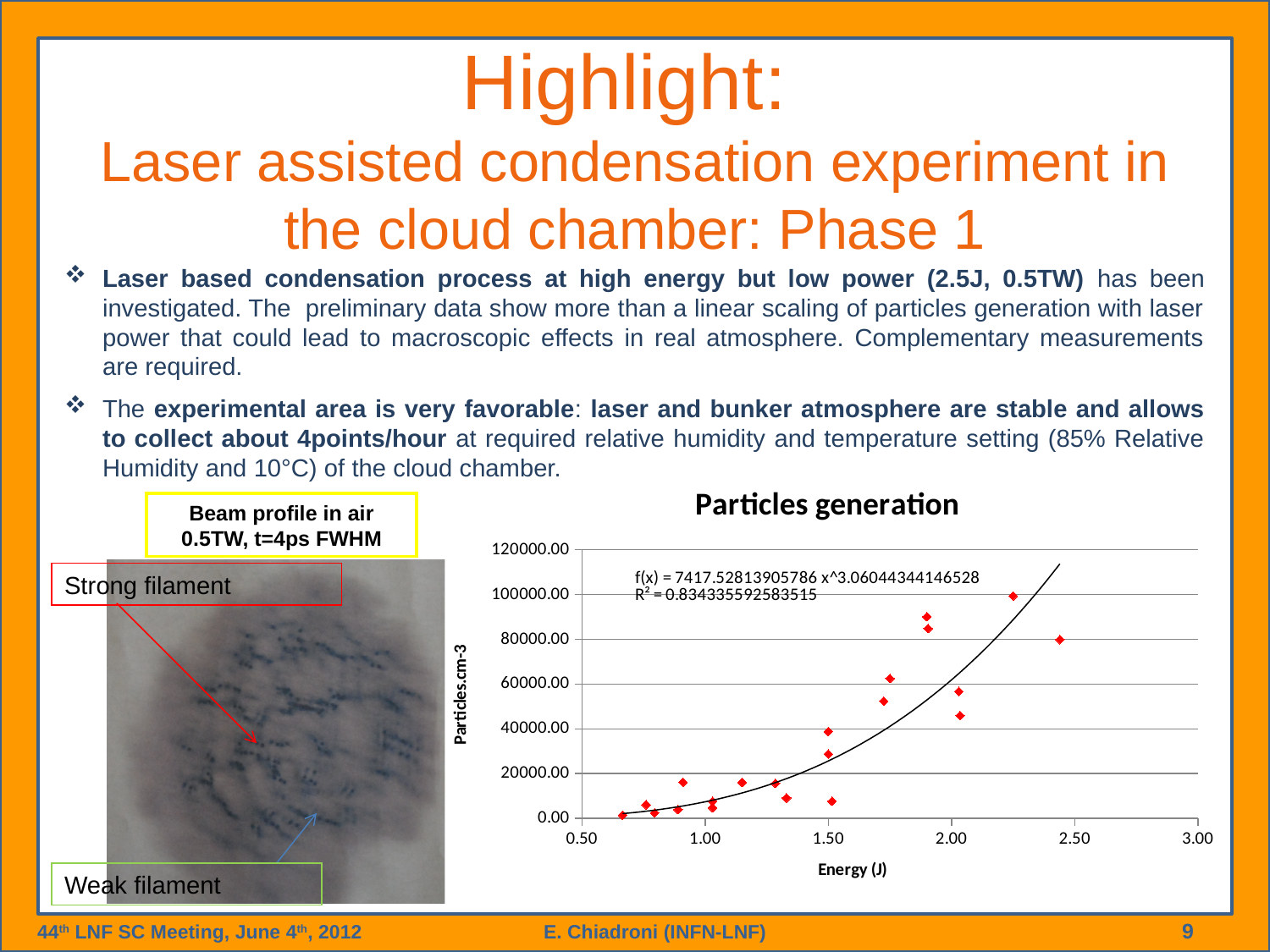
What kind of chart is the "Particles generation" chart? Scatter chart In the "Particles generation" chart, are the points plotted at about 1.00 J greater or less than 20000.00 particles.cm-3? less In the "Particles generation" chart, do the particle counts generally rise or fall as energy increases along the x axis? Rise In the "Particles generation" chart, is the lowest-energy point (at about 0.65 J) greater or less than 20000.00 particles.cm-3? less In the "Particles generation" chart, does the highest particle value occur at an energy greater or less than 2.00 J? greater What R² value is printed on the "Particles generation" chart for the fitted curve? R² = 0.834335592583515 What is the title of the chart on the slide? Particles generation